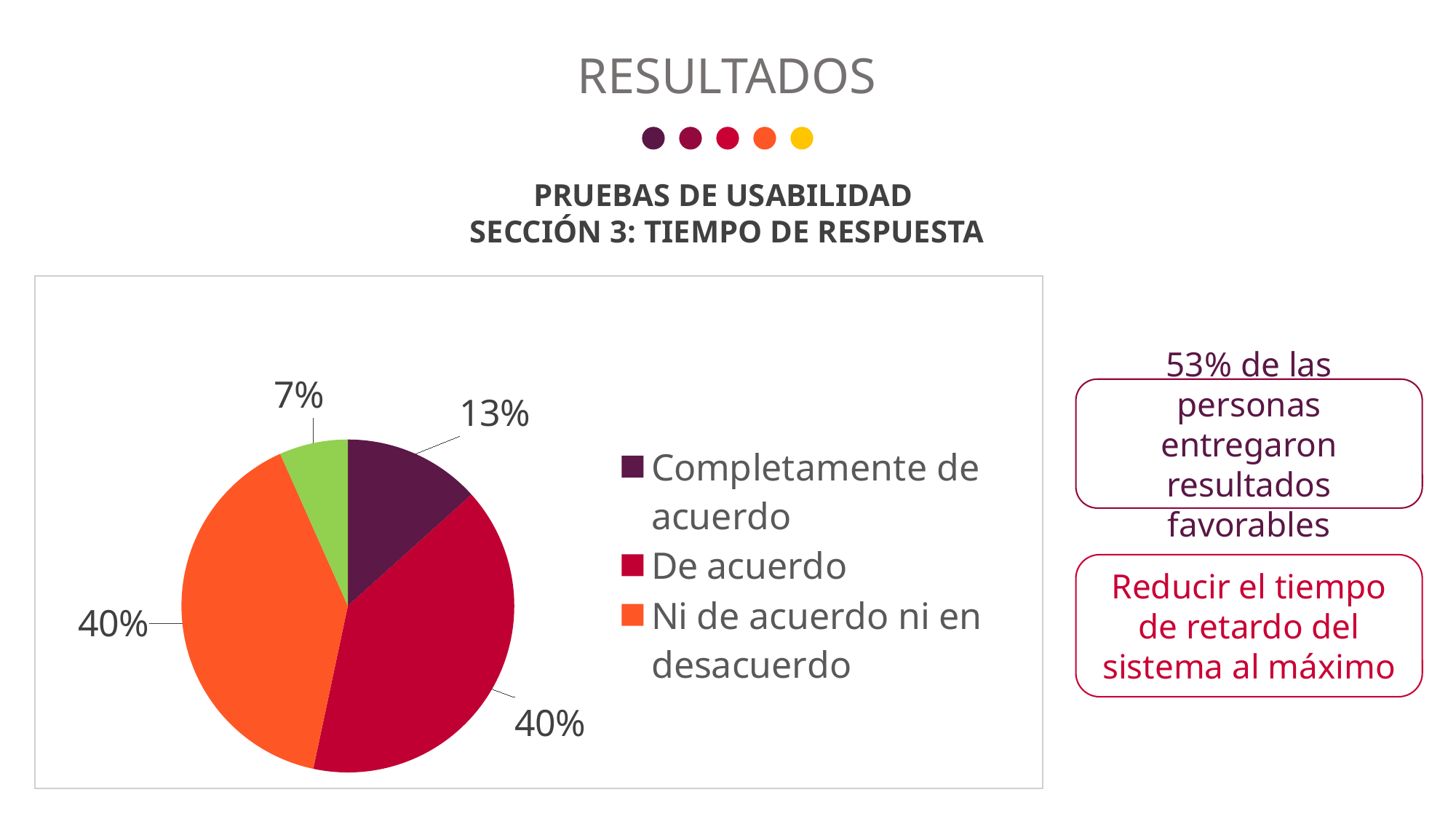
Which is larger: the share for "De acuerdo" or the share for "Completamente de acuerdo"? De acuerdo What percentage of the pie chart corresponds to "Ni de acuerdo ni en desacuerdo"? 40% What percentage of the pie chart corresponds to "De acuerdo"? 40% What colour is the "De acuerdo" slice in the pie chart? Red What is the heading above the chart on the slide? PRUEBAS DE USABILIDAD SECCIÓN 3: TIEMPO DE RESPUESTA How many entries does the chart legend list? 3 By how many percentage points does "De acuerdo" exceed "Completamente de acuerdo"? 27 percentage points What kind of chart is shown on the slide? Pie chart How many slices does the pie chart have? 4 What is the smallest percentage label shown on the pie chart? 7% What is the combined share of "Completamente de acuerdo" and "De acuerdo"? 53% What percentage of the pie chart corresponds to "Completamente de acuerdo"? 13%